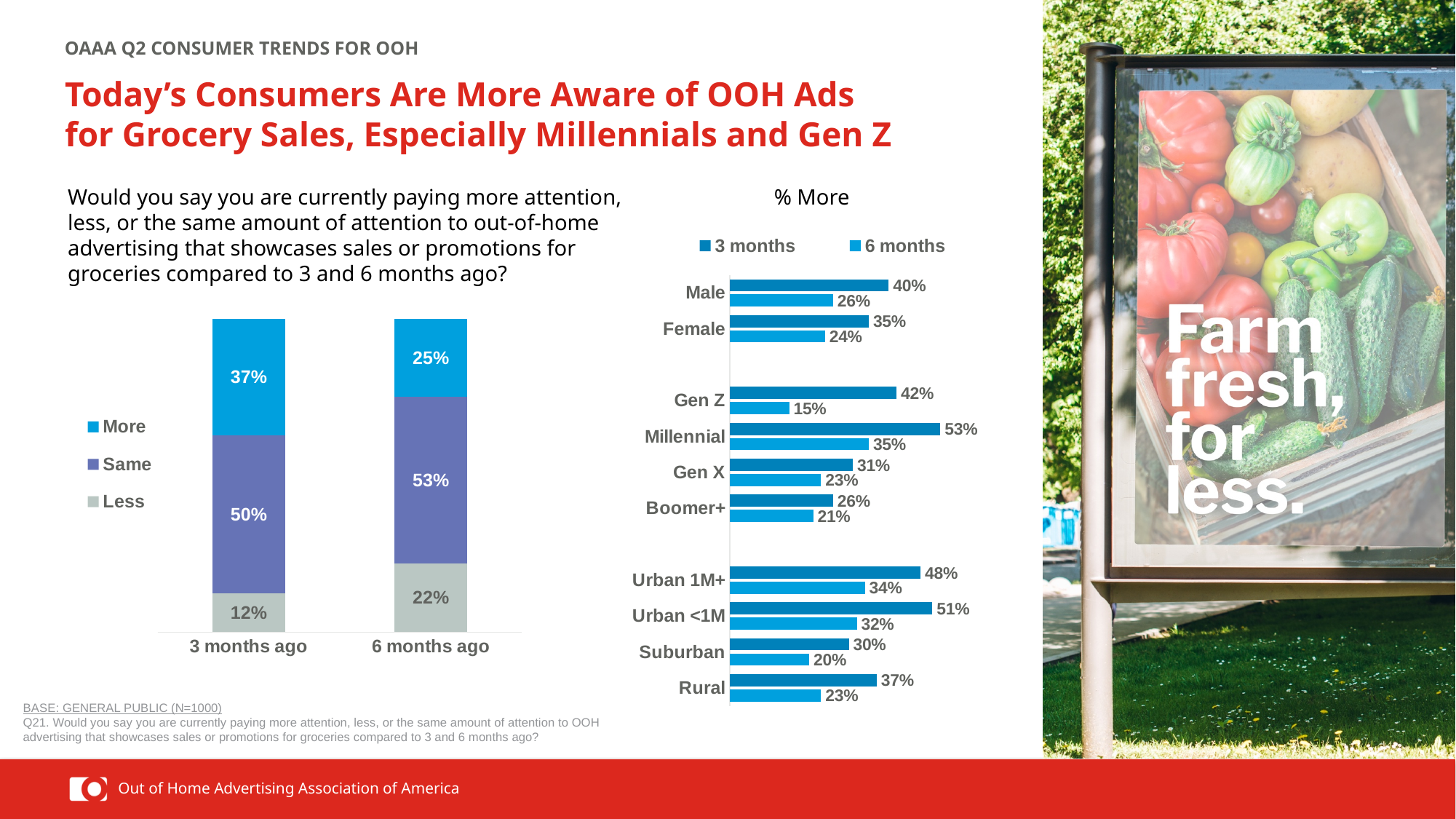
In the '% More' chart, what is the difference between the 3 months and 6 months values for Urban <1M? 19% What kind of chart is the '% More' chart? Bar chart In the '% More' chart, which category has the lowest 6 months value? Gen Z In the '% More' chart, what is the 6 months value for Gen Z? 15% In the '% More' chart, which is larger: the 3 months value for Male or the 3 months value for Female? Male In the stacked bar chart on the left, what is the difference between the 'Same' values for 6 months ago and 3 months ago? 3% In the stacked bar chart on the left, what percentage said 'Less' for 6 months ago? 22% In the stacked bar chart on the left, what percentage said 'More' for 3 months ago? 37% In the '% More' chart, how many categories are shown? 10 In the '% More' chart, which category has the highest 3 months value? Millennial In the '% More' chart, what is the 3 months value for Millennial? 53% In the stacked bar chart on the left, how many series does the legend list? 3